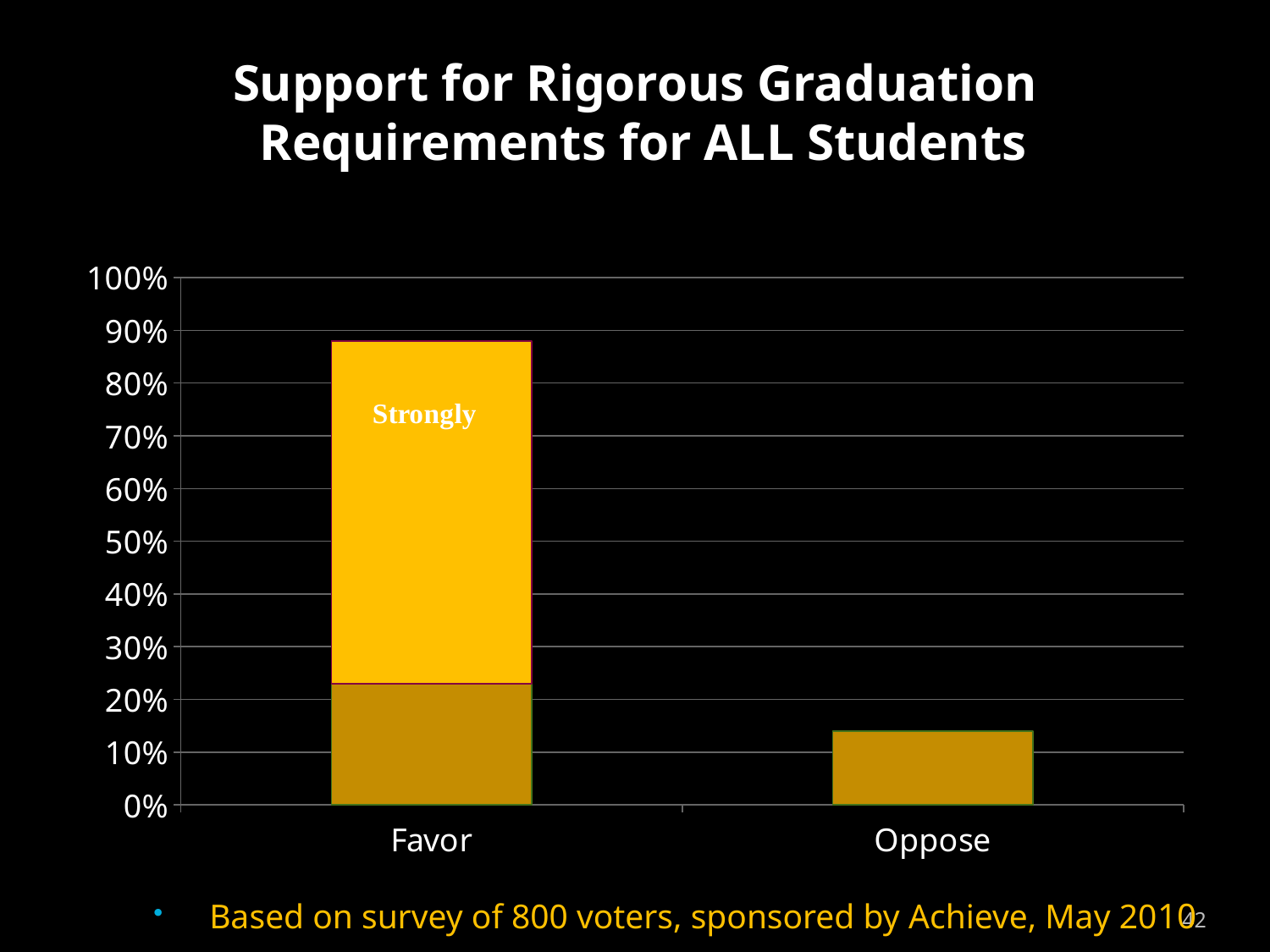
Which category has the tallest bar? Favor Which bar is taller, Favor or Oppose? Favor Is the value for Oppose greater or less than 10%? greater What is the title of the chart? Support for Rigorous Graduation Requirements for ALL Students How many categories are shown on the x axis? 2 Is the value for Favor greater or less than 50%? greater Is the value for Oppose greater or less than 20%? less What kind of chart is shown on the slide? bar chart Which category has the shortest bar? Oppose What word is printed inside the upper segment of the Favor bar? Strongly